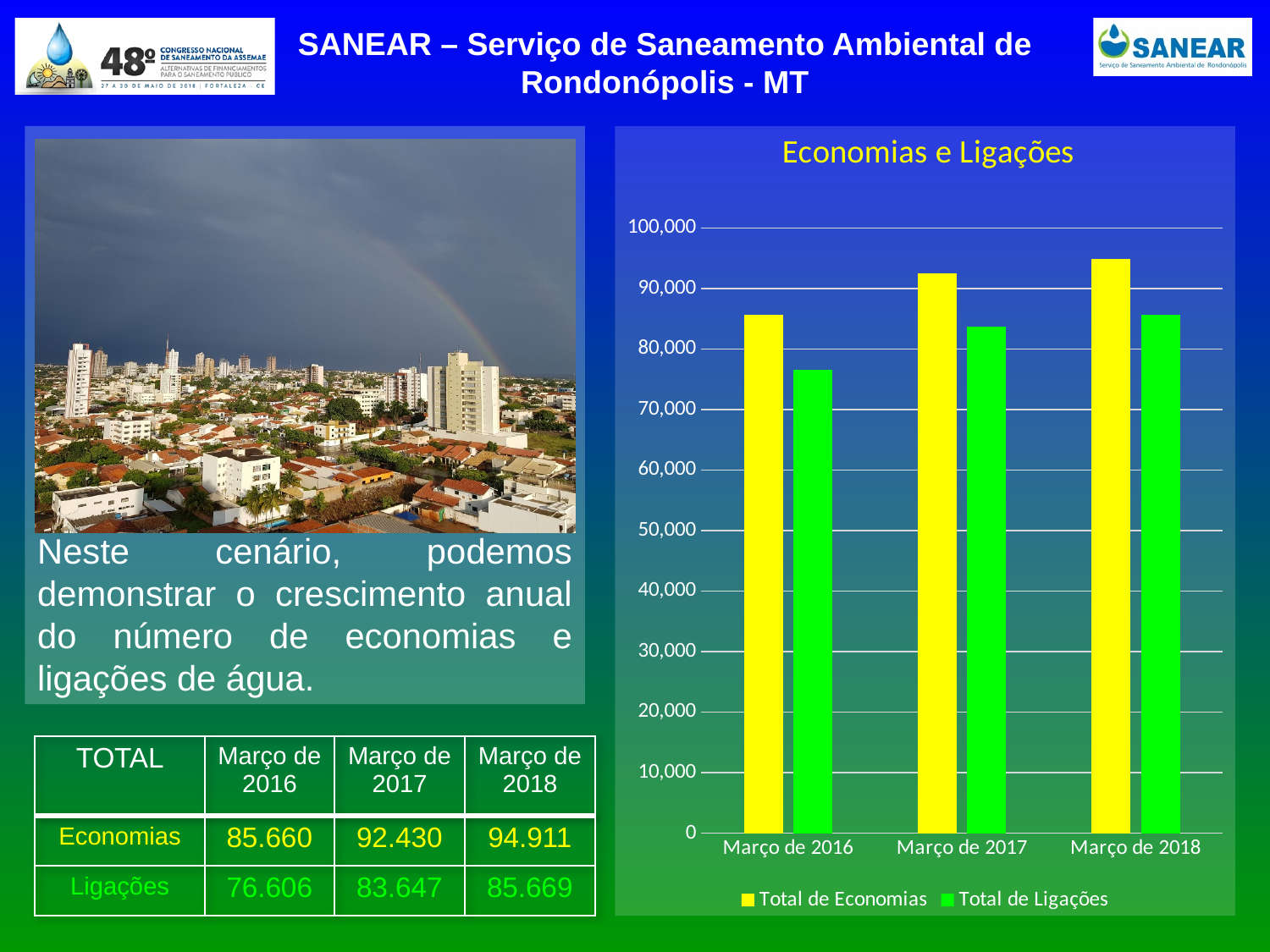
What is the value of Total de Ligações for Março de 2018? 85.669 What kind of chart is shown under the title "Economias e Ligações"? bar chart In Março de 2018, which is larger: Total de Economias or Total de Ligações? Total de Economias Do the Total de Economias values rise or fall from Março de 2016 to Março de 2018? rise In which category is Total de Economias highest? Março de 2018 What colour are the Total de Ligações bars in the chart? green How many series does the chart's legend list? 2 How many categories are shown on the x axis of the chart? 3 Is the value for Total de Economias in Março de 2017 greater or less than 90,000? greater What is the value of Total de Economias for Março de 2016? 85.660 In which category is Total de Ligações lowest? Março de 2016 Is the value for Total de Ligações in Março de 2016 greater or less than 80,000? less